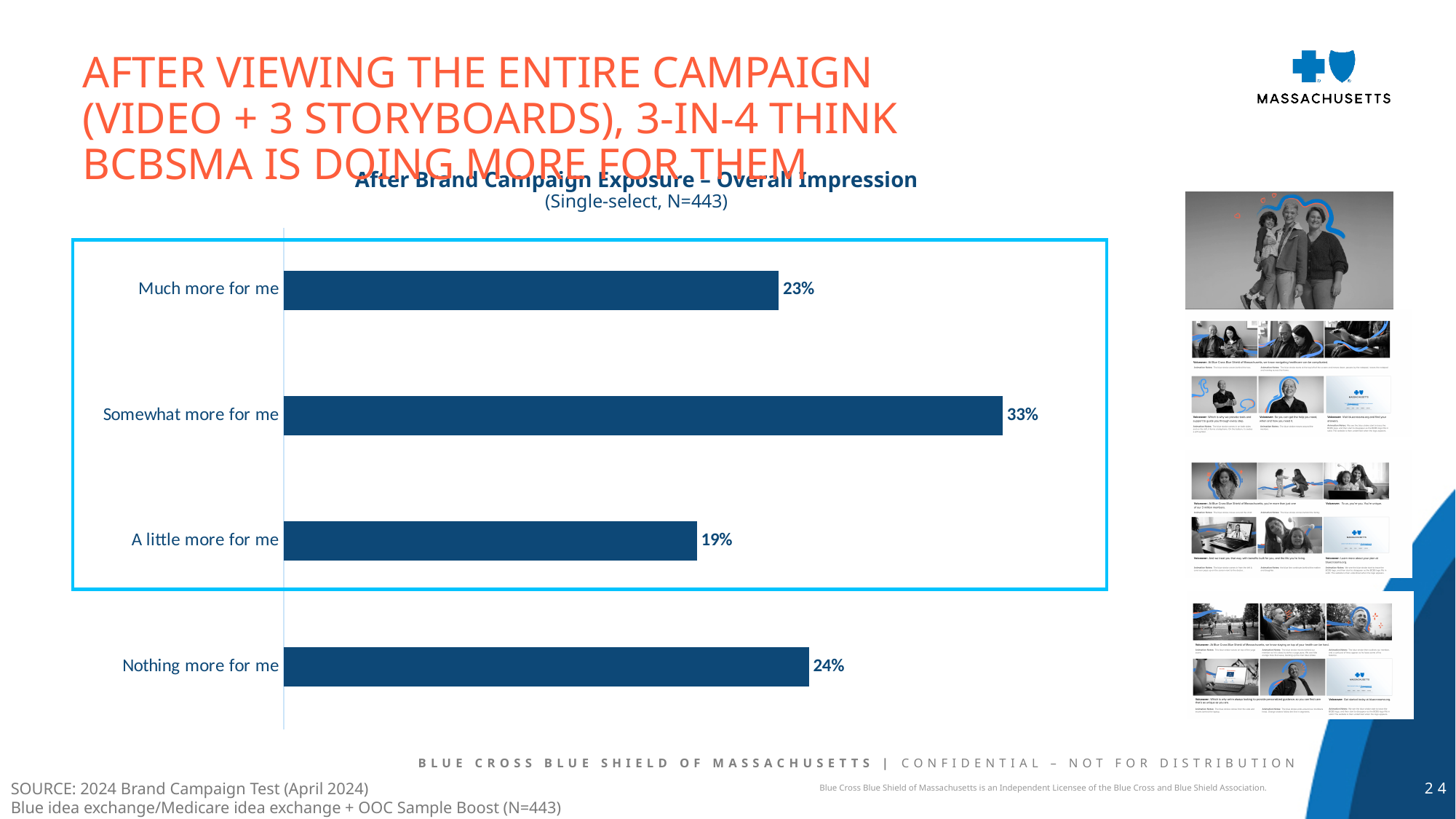
What is the difference in percentage points between "Somewhat more for me" and "A little more for me"? 14 percentage points What type of chart is shown on the slide? Bar chart Which response category has the lowest percentage? A little more for me What percentage of respondents said "Nothing more for me"? 24% What is the sample size (N) stated in the chart subtitle? N=443 Which response category has the highest percentage? Somewhat more for me What percentage of respondents said "Somewhat more for me"? 33% Which is larger: the percentage for "Much more for me" or for "Nothing more for me"? Nothing more for me What percentage of respondents said "A little more for me"? 19% What percentage of respondents said "Much more for me"? 23% What is the combined percentage of the three categories inside the highlighted box (Much more, Somewhat more, A little more for me)? 75% How many response categories are shown in the chart? 4